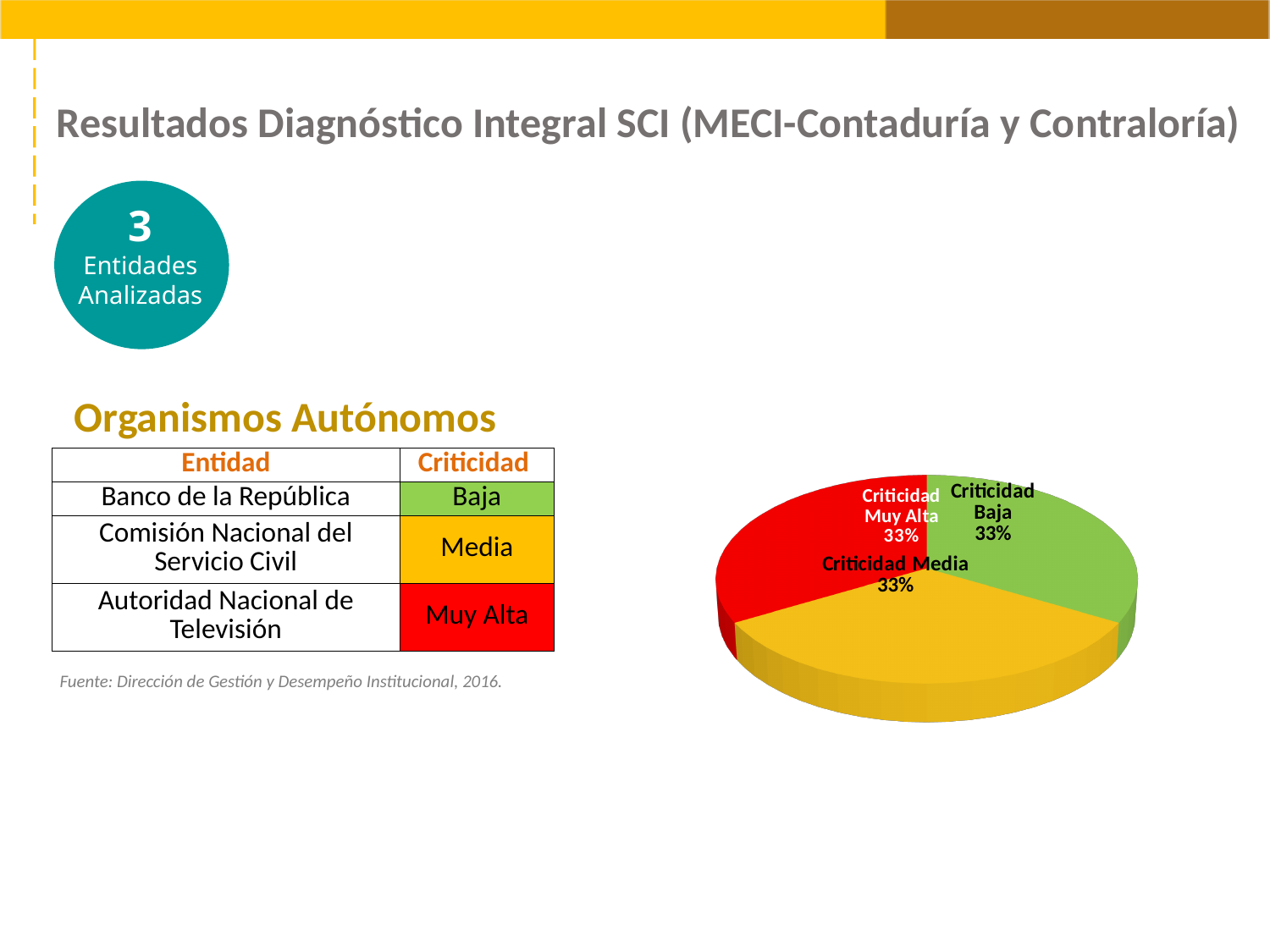
What colour is the Criticidad Muy Alta slice of the pie chart? red What is the value printed on the Criticidad Media slice? 33% What is the difference between the shares of Criticidad Media and Criticidad Baja? 0% What share of the pie does Criticidad Baja represent? 33% How many slices does the pie chart have? 3 What share of the pie does Criticidad Muy Alta represent? 33% Is the share for Criticidad Baja larger than, smaller than, or equal to the share for Criticidad Muy Alta? equal What kind of chart is shown on the slide? pie chart What colour is the Criticidad Baja slice of the pie chart? green What share of the pie does Criticidad Media represent? 33%